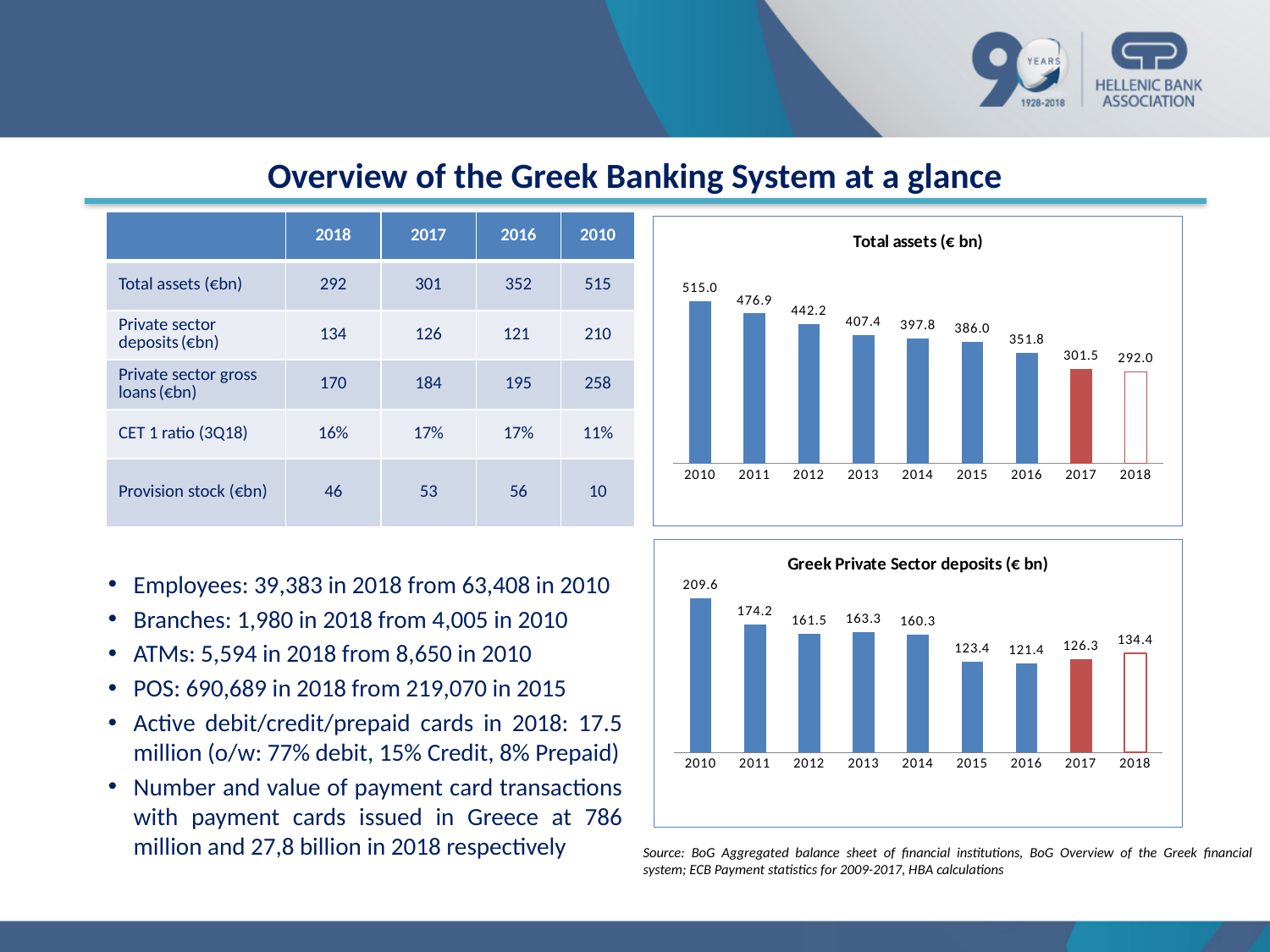
In the 'Total assets (€ bn)' chart, which year's bar is drawn as an outline rather than filled? 2018 In the 'Total assets (€ bn)' chart, do the values rise or fall from 2010 to 2018? fall In the 'Greek Private Sector deposits (€ bn)' chart, which is larger, the value for 2013 or the value for 2014? 2013 In the 'Total assets (€ bn)' chart, which year has the highest value? 2010 In the 'Greek Private Sector deposits (€ bn)' chart, what is the value for 2015? 123.4 In the 'Greek Private Sector deposits (€ bn)' chart, what is the difference between the 2018 and 2017 values? 8.1 In the 'Total assets (€ bn)' chart, what is the value for 2012? 442.2 In the 'Total assets (€ bn)' chart, how many years are plotted? 9 What kind of chart is the 'Greek Private Sector deposits (€ bn)' chart? bar chart In the 'Total assets (€ bn)' chart, what is the difference between the 2010 and 2018 values? 223.0 In the 'Greek Private Sector deposits (€ bn)' chart, which year has the lowest value? 2016 In the 'Total assets (€ bn)' chart, which year has the lowest value? 2018